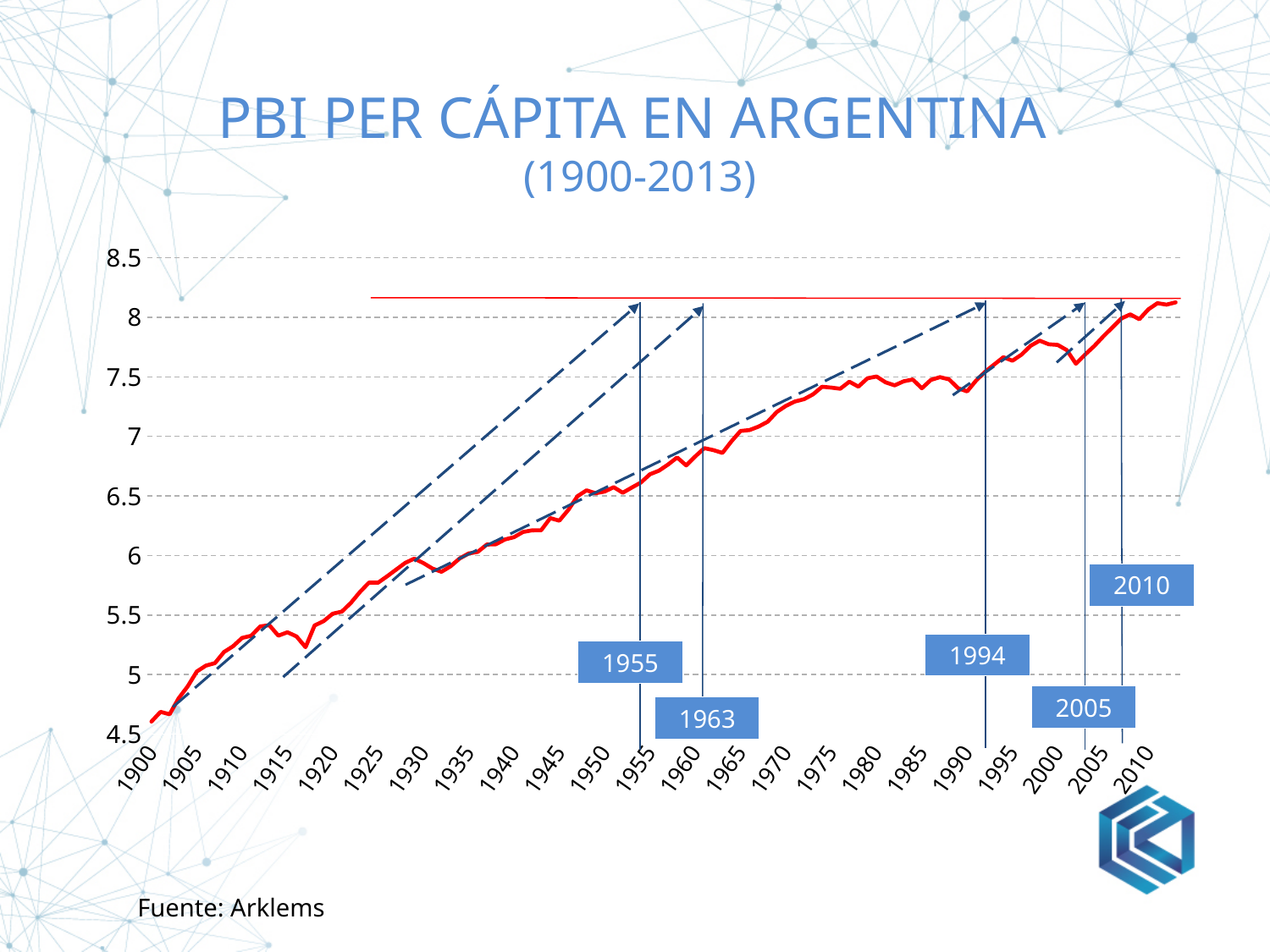
What is the title of the chart? PBI PER CÁPITA EN ARGENTINA (1900-2013) Is the value for 1910 greater or less than 5? greater What kind of chart is shown on the slide? Line chart Is the value for 1900 greater or less than 5? less In which year is the plotted value lowest? 1900 Is the value for 1925 greater or less than 5.5? greater Does the red line generally rise or fall from 1900 to 2013? Rise What source is cited for the chart data? Arklems How many year labels are shown on the x axis? 23